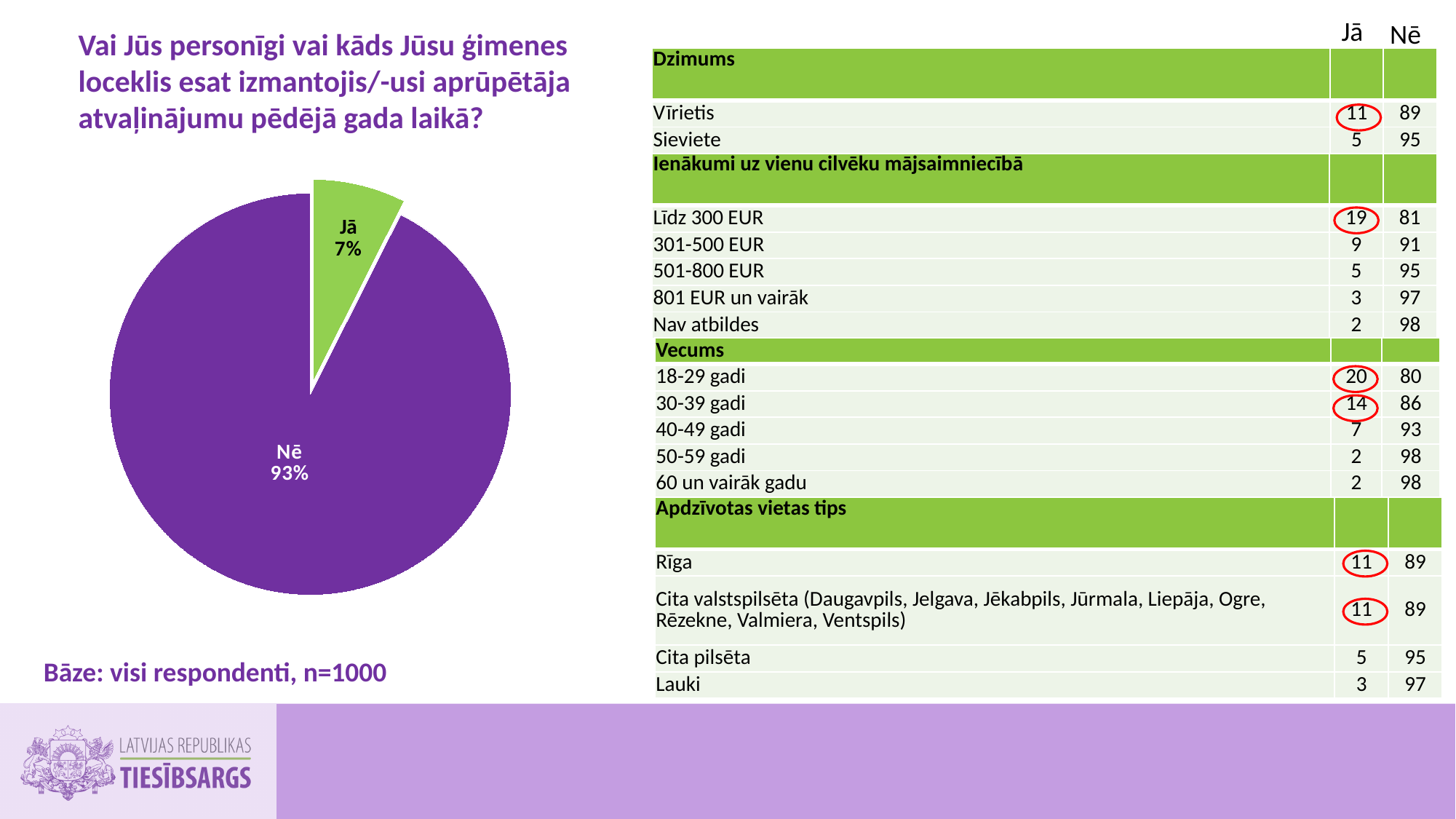
Which is larger in the pie chart, the "Jā" slice or the "Nē" slice? Nē What is the base (n) of respondents stated below the pie chart? n=1000 What type of chart is shown on the slide? pie chart Which slice of the pie chart is the smallest? Jā How many slices does the pie chart have? 2 What is the difference in percentage points between the "Nē" and "Jā" slices of the pie chart? 86 What colour is the "Nē" slice of the pie chart? purple What share of the pie chart is labelled "Nē"? 93% What colour is the "Jā" slice of the pie chart? green Which slice of the pie chart is the largest? Nē What share of the pie chart is labelled "Jā"? 7%